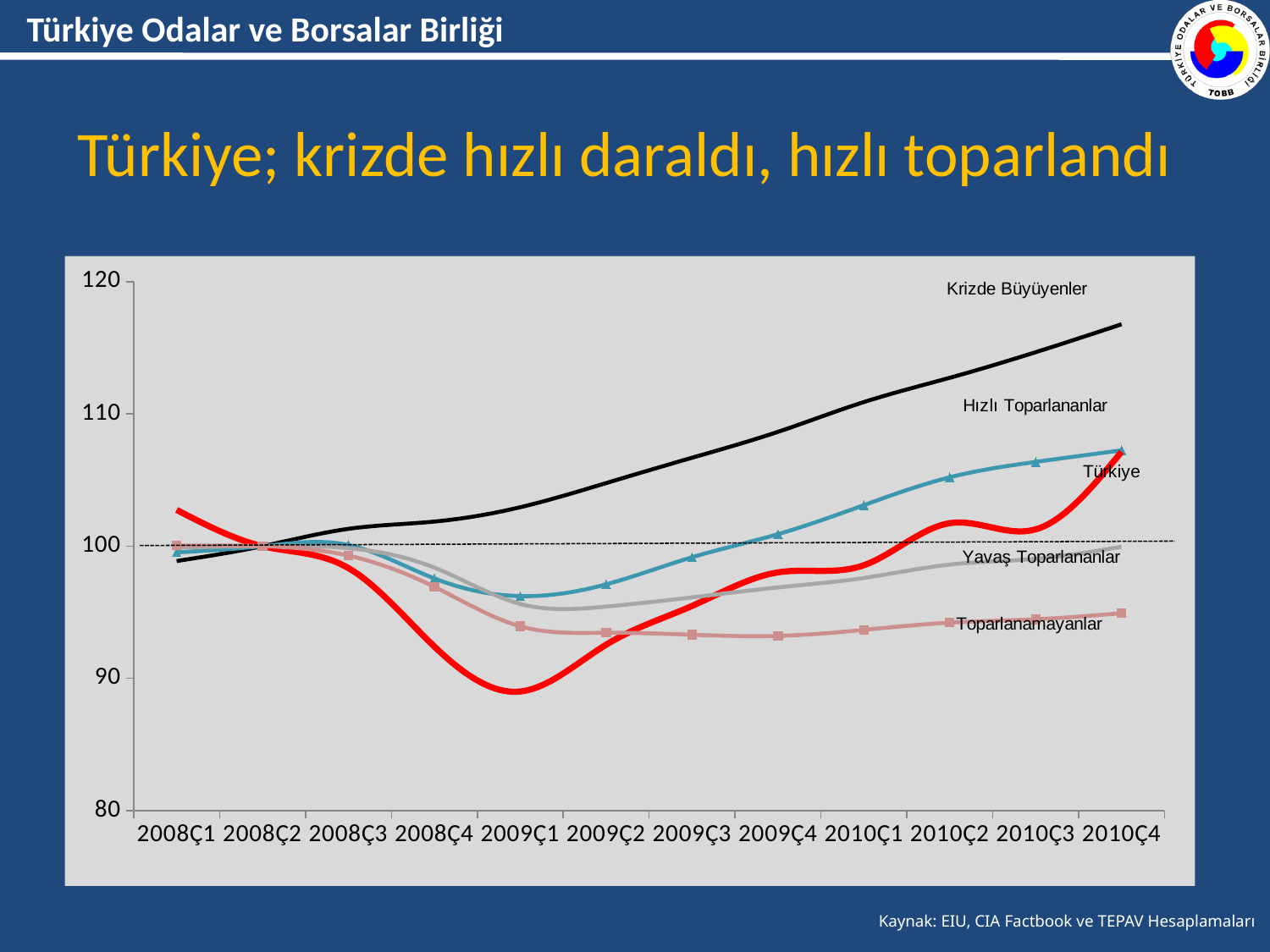
How many quarters are shown along the x axis of the chart? 12 At 2010Ç4, which is larger: the value for Türkiye or the value for Toparlanamayanlar? Türkiye Is the value for Krizde Büyüyenler at 2010Ç4 greater or less than 110? greater Which series has the lowest value at 2010Ç4? Toparlanamayanlar Which series has the highest value at 2010Ç4? Krizde Büyüyenler How many series are plotted on the chart? 5 Is the value for Toparlanamayanlar at 2010Ç4 greater or less than 100? less What is the title of the slide above the chart? Türkiye; krizde hızlı daraldı, hızlı toparlandı What kind of chart is shown on the slide? line chart Which series has the lowest value at 2009Ç1? Türkiye Does the Krizde Büyüyenler series rise or fall from 2008Ç1 to 2010Ç4? rise Is the value for Türkiye at 2009Ç1 greater or less than 90? less